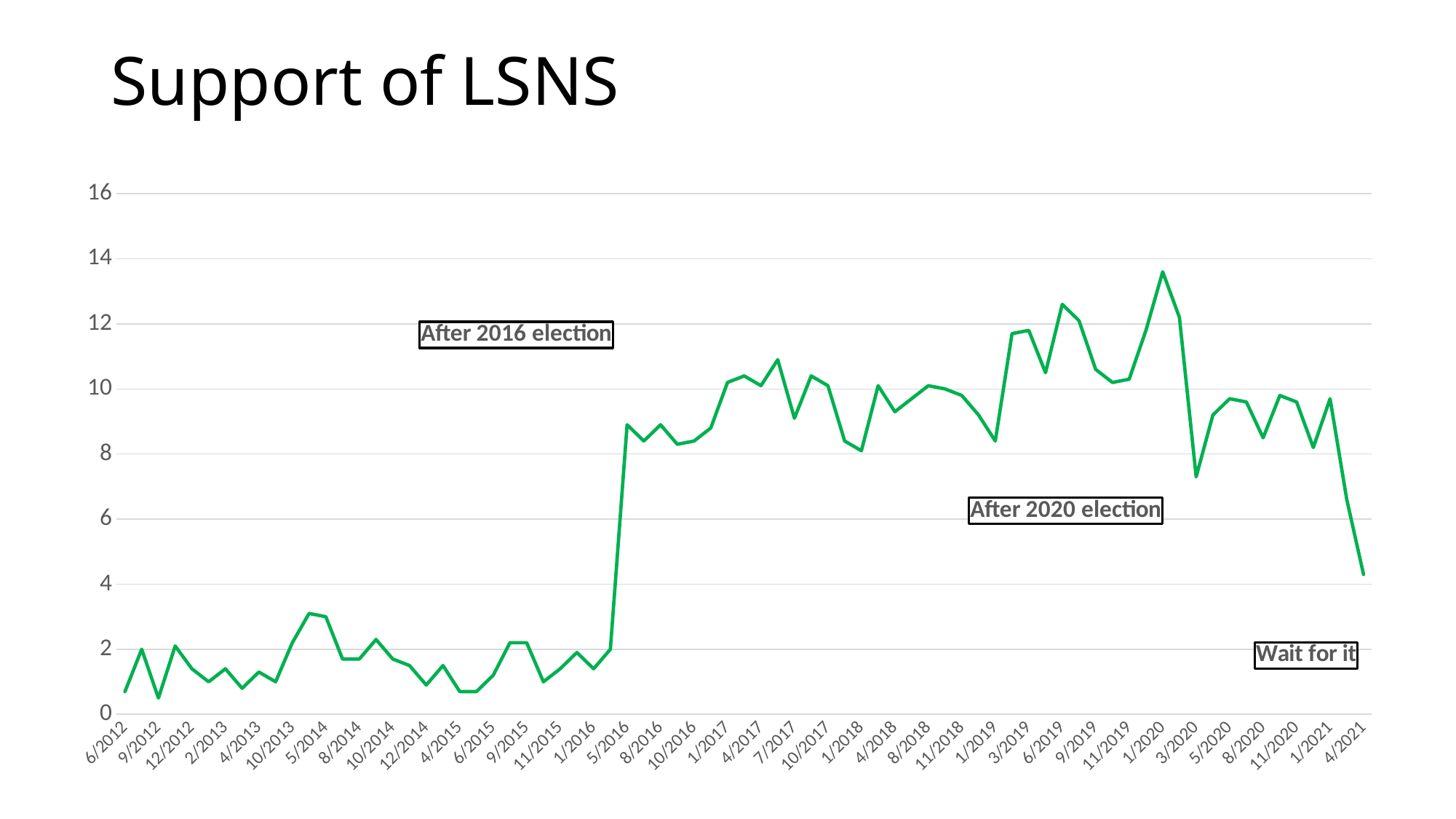
Is the value for 3/2020 greater or less than 10? less Is the value for 4/2021 greater or less than 6? less Which is larger, the value for 6/2012 or the value for 5/2016? 5/2016 What colour is the line in the chart? Green Which is larger, the value for 1/2020 or the value for 4/2021? 1/2020 At which date does the line reach its highest value? 1/2020 Is the value for 6/2012 greater or less than 2? less What is the title of the chart? Support of LSNS Does the line rise or fall between 1/2021 and 4/2021? Fall What kind of chart is shown on the slide? Line chart